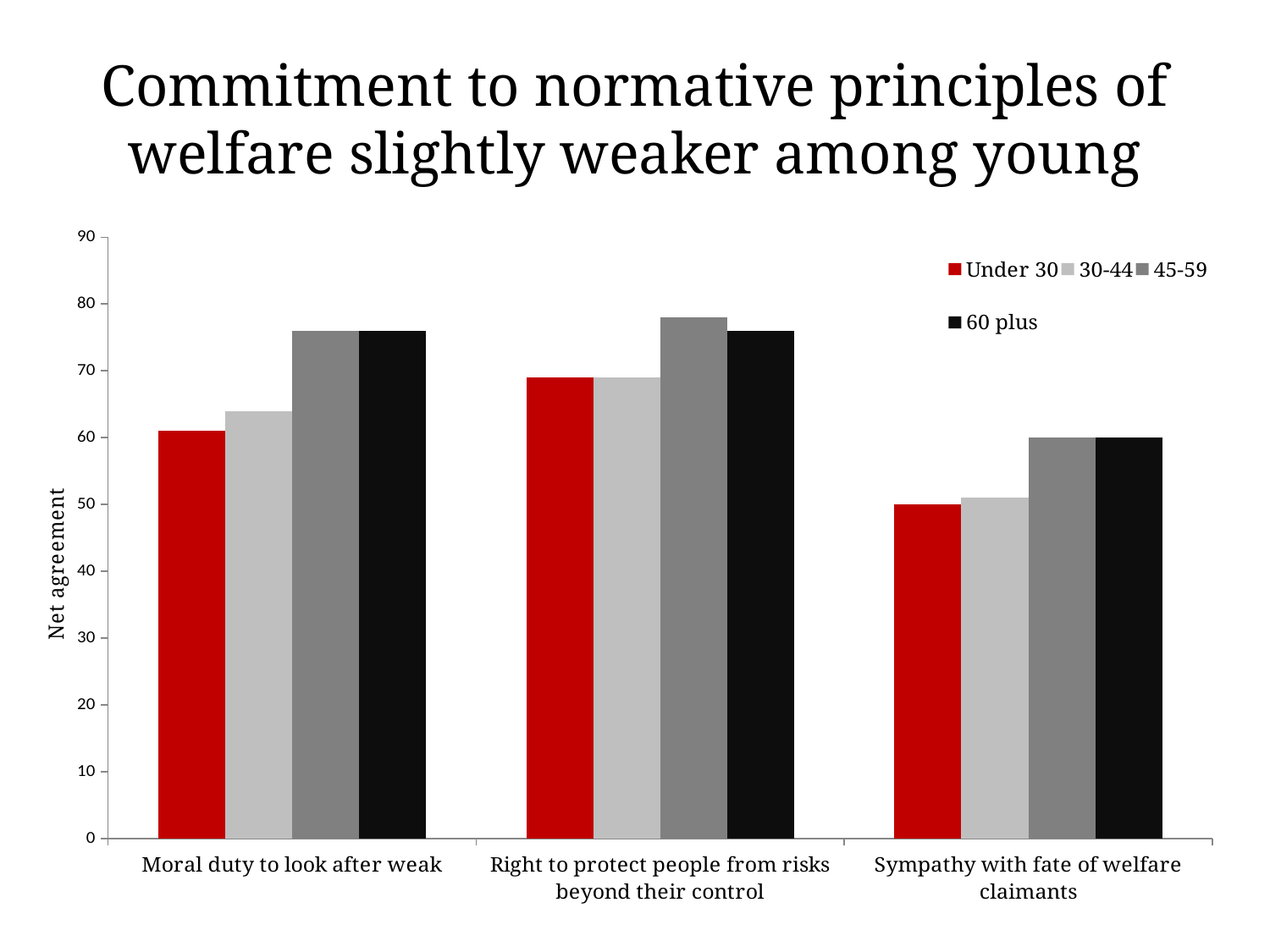
How many categories are shown on the x axis? 3 What kind of chart is shown on the slide? bar chart For the Under 30 series, which category has the lowest value? Sympathy with fate of welfare claimants Is the value for 60 plus in 'Moral duty to look after weak' greater or less than 70? greater What is the label on the vertical axis? Net agreement In 'Moral duty to look after weak', which is larger: the Under 30 value or the 45-59 value? 45-59 How many series does the legend list? 4 Is the value for 45-59 in 'Right to protect people from risks beyond their control' greater or less than 70? greater Is the value for Under 30 in 'Moral duty to look after weak' greater or less than 70? less In 'Sympathy with fate of welfare claimants', which is larger: the 30-44 value or the 60 plus value? 60 plus Which colour represents the Under 30 series in the legend? red